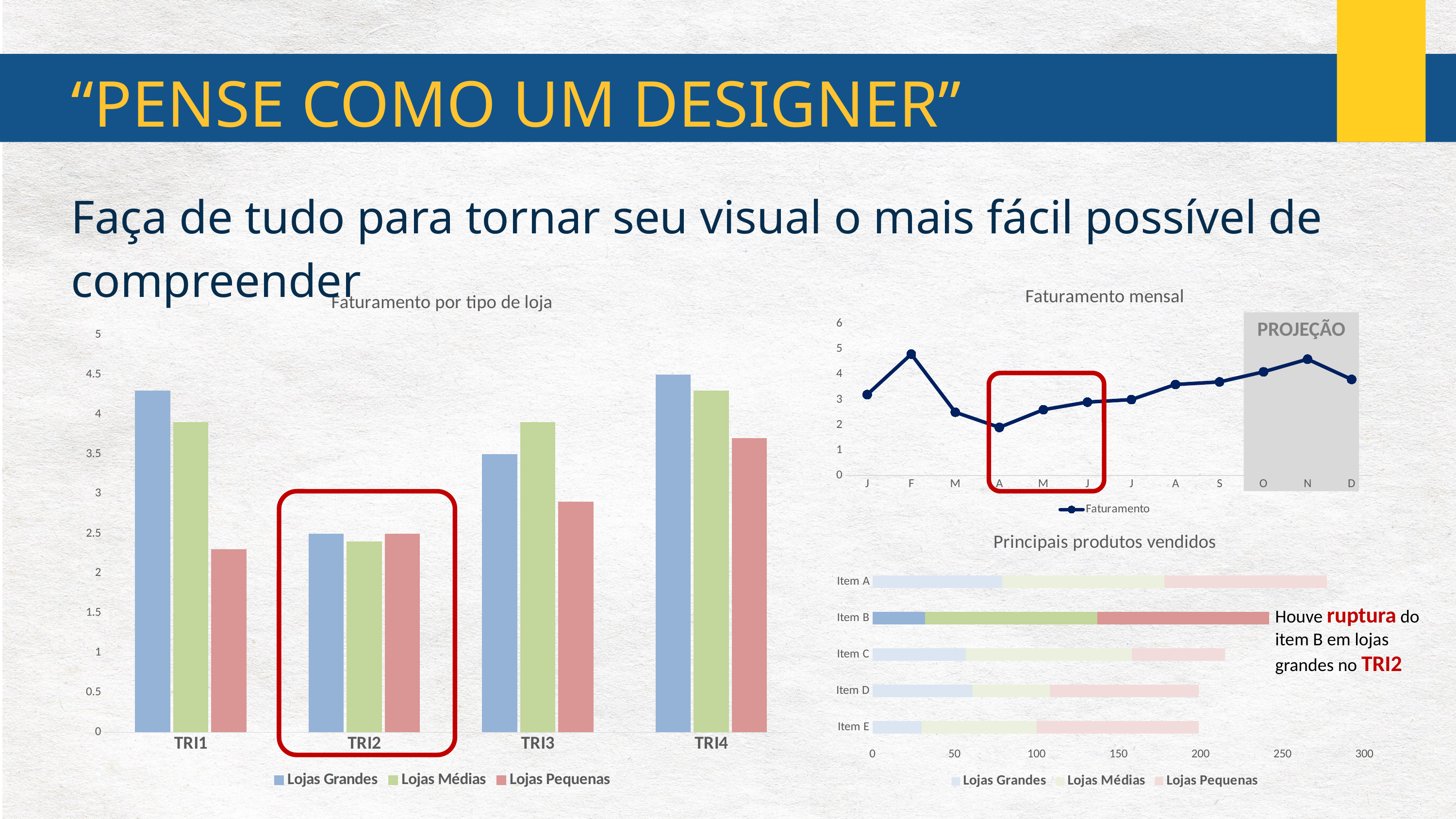
In "Faturamento mensal", which x-axis label has the highest value? F What kind of chart is "Faturamento por tipo de loja"? bar chart In "Faturamento por tipo de loja", which series has the highest value in TRI1? Lojas Grandes How many categories are shown on the x axis of "Faturamento por tipo de loja"? 4 What kind of chart is "Faturamento mensal"? line chart In "Faturamento mensal", is the value at F greater or less than 4? greater In "Faturamento por tipo de loja", is the value for Lojas Grandes in TRI1 greater or less than 4? greater In "Faturamento mensal", what label appears in the grey shaded area at the right of the chart? PROJEÇÃO How many series does the legend of "Faturamento por tipo de loja" list? 3 In "Faturamento por tipo de loja", which is larger in TRI3: Lojas Grandes or Lojas Médias? Lojas Médias How many items are listed on the y axis of "Principais produtos vendidos"? 5 In "Faturamento por tipo de loja", is the value for Lojas Pequenas in TRI2 greater or less than 3? less